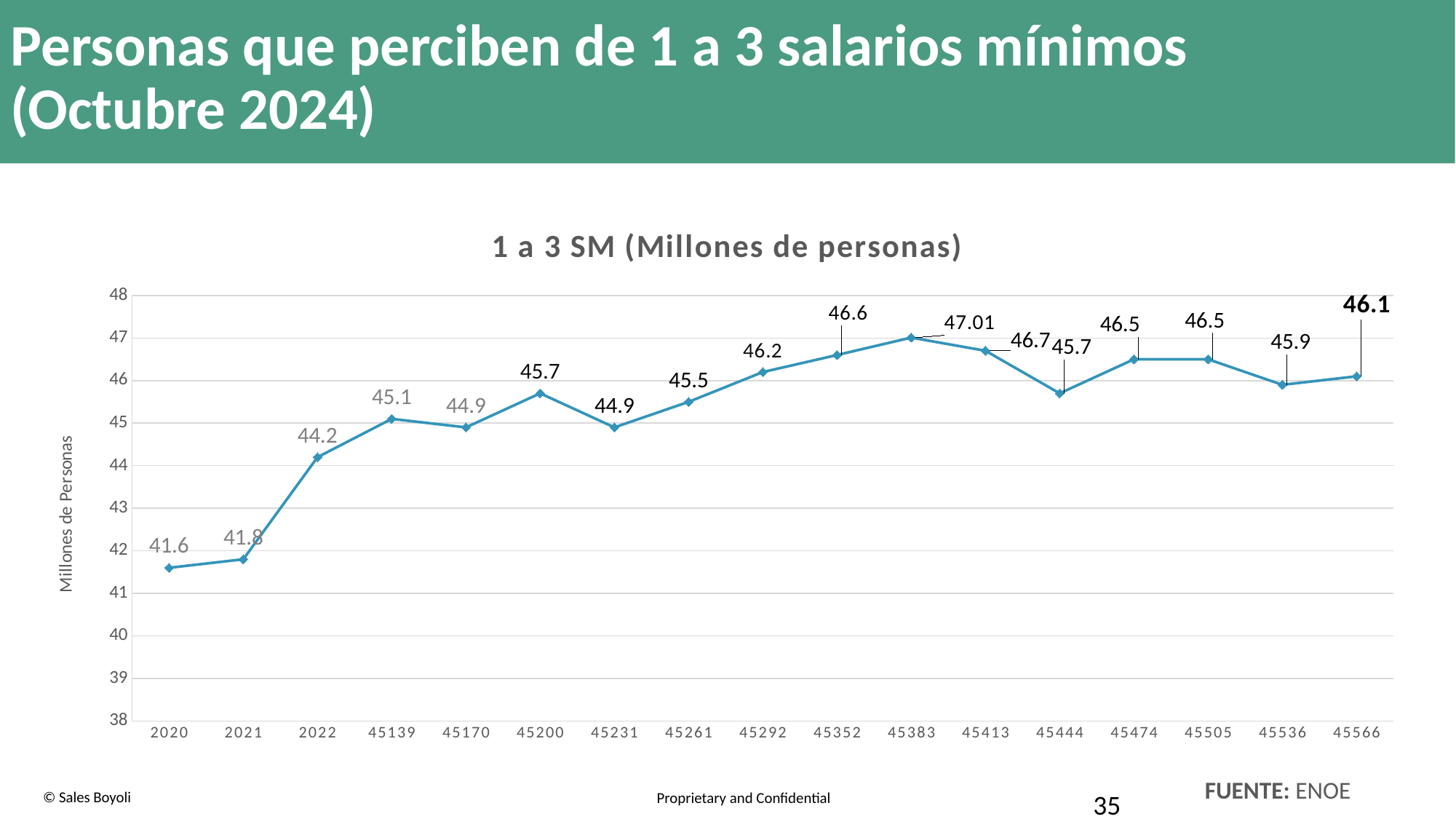
What kind of chart is shown on the slide? line chart How many data points are plotted on the chart? 17 What is the value for 2020? 41.6 Is the value for 45292 greater or less than 46? greater What is the value for 45383? 47.01 Which category has the highest value? 45383 What is the title of the chart? 1 a 3 SM (Millones de personas) What is the difference between the values for 2022 and 2021? 2.4 Which is larger, the value for 45200 or the value for 45231? 45200 What is the value for 2022? 44.2 Which category has the lowest value? 2020 What is the value for 45566? 46.1